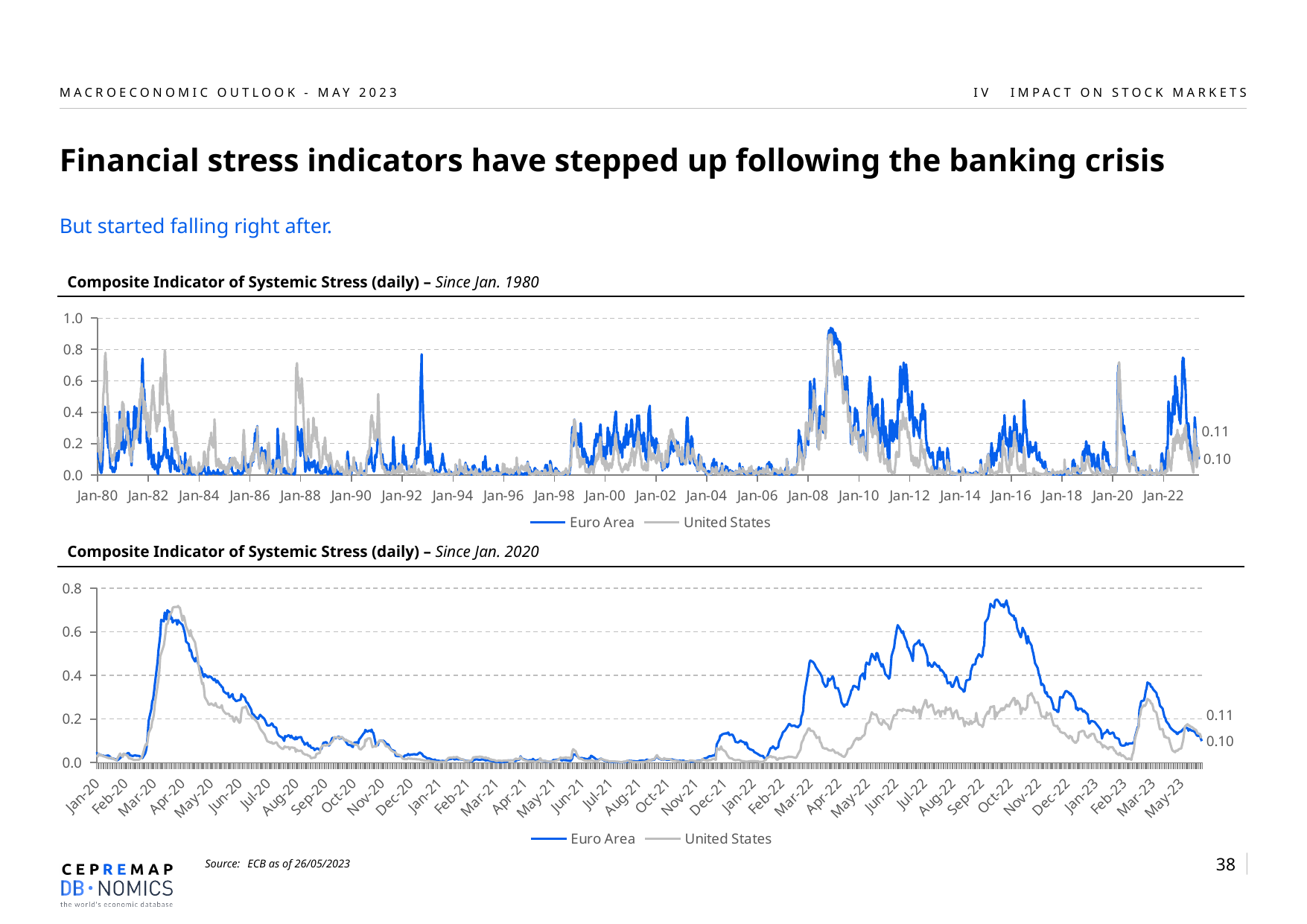
In the bottom chart (Since Jan. 2020), is the peak value of the United States series around Apr-20 greater or less than 0.6? greater In the bottom chart (Since Jan. 2020), is the Euro Area value around Mar-21 greater or less than 0.2? less In the top chart (Since Jan. 1980), is the peak value of the Euro Area series around 2008–2009 greater or less than 0.8? greater In the bottom chart (Since Jan. 2020), which series is higher around Oct-22, Euro Area or United States? Euro Area What period does the subtitle of the top chart say the data covers? Since Jan. 1980 Which two series are listed in the legend of the top chart? Euro Area and United States In the bottom chart (Since Jan. 2020), does the Euro Area series rise or fall between Mar-23 and May-23? fall In the bottom chart (Since Jan. 2020), what is the higher of the two latest values labelled at the right end of the lines? 0.11 How many series does the legend of the bottom chart, 'Composite Indicator of Systemic Stress (daily) – Since Jan. 2020', list? 2 What kind of chart is the top chart, 'Composite Indicator of Systemic Stress (daily) – Since Jan. 1980'? Line chart